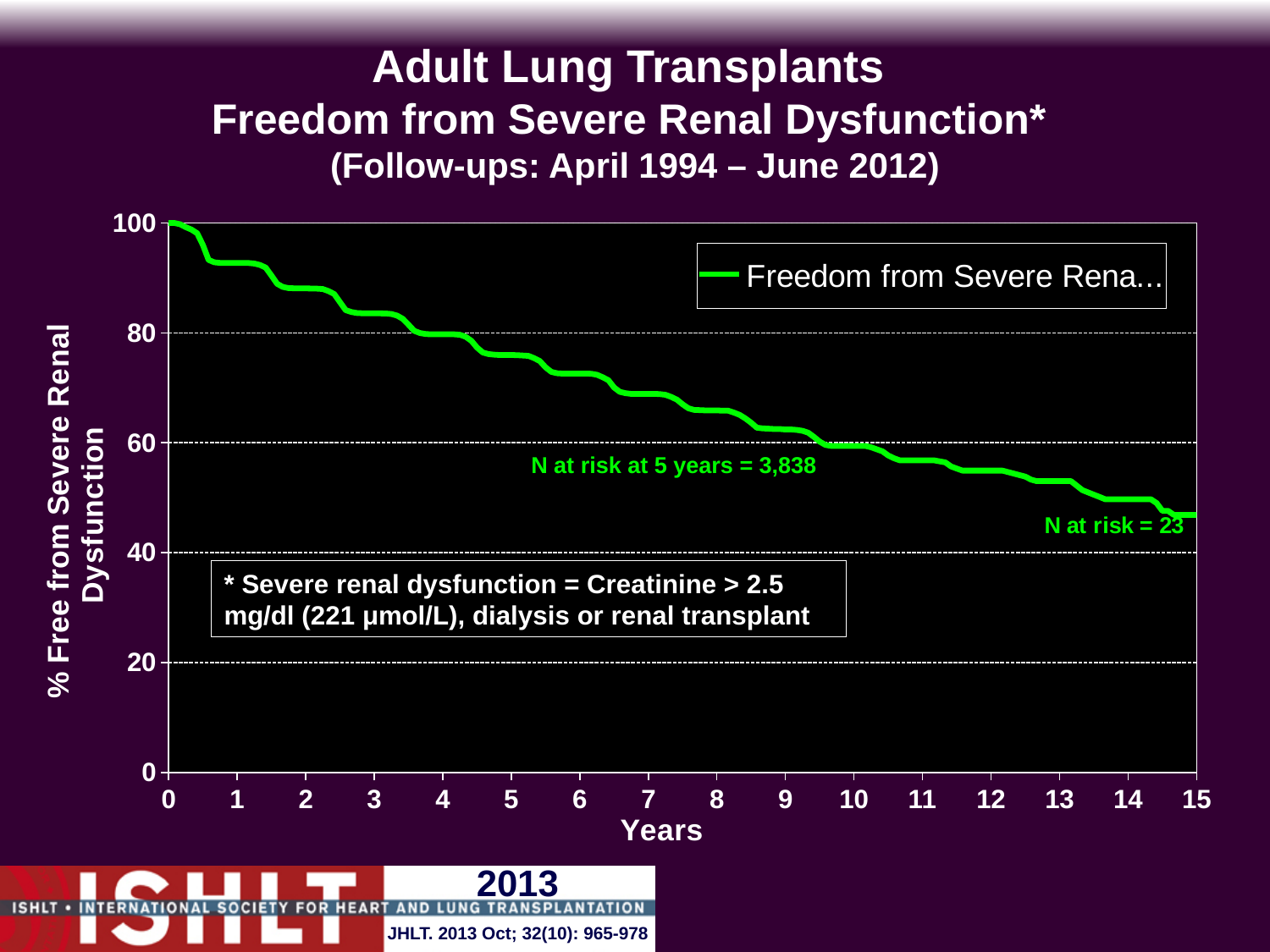
What is the N at risk at 5 years shown on the chart? 3,838 What kind of chart is shown on the slide? line chart What colour is the plotted line? green Does the plotted line rise or fall as the years increase? fall Is the value of the line at year 15 greater or less than 60? less Is the value of the line at year 5 greater or less than 60? greater Is the value of the line at year 13 greater or less than 60? less What is the label of the x axis? Years What is the value of the line at year 0? 100 How many series does the legend list? 1 What is the N at risk value shown near the right end of the line? 23